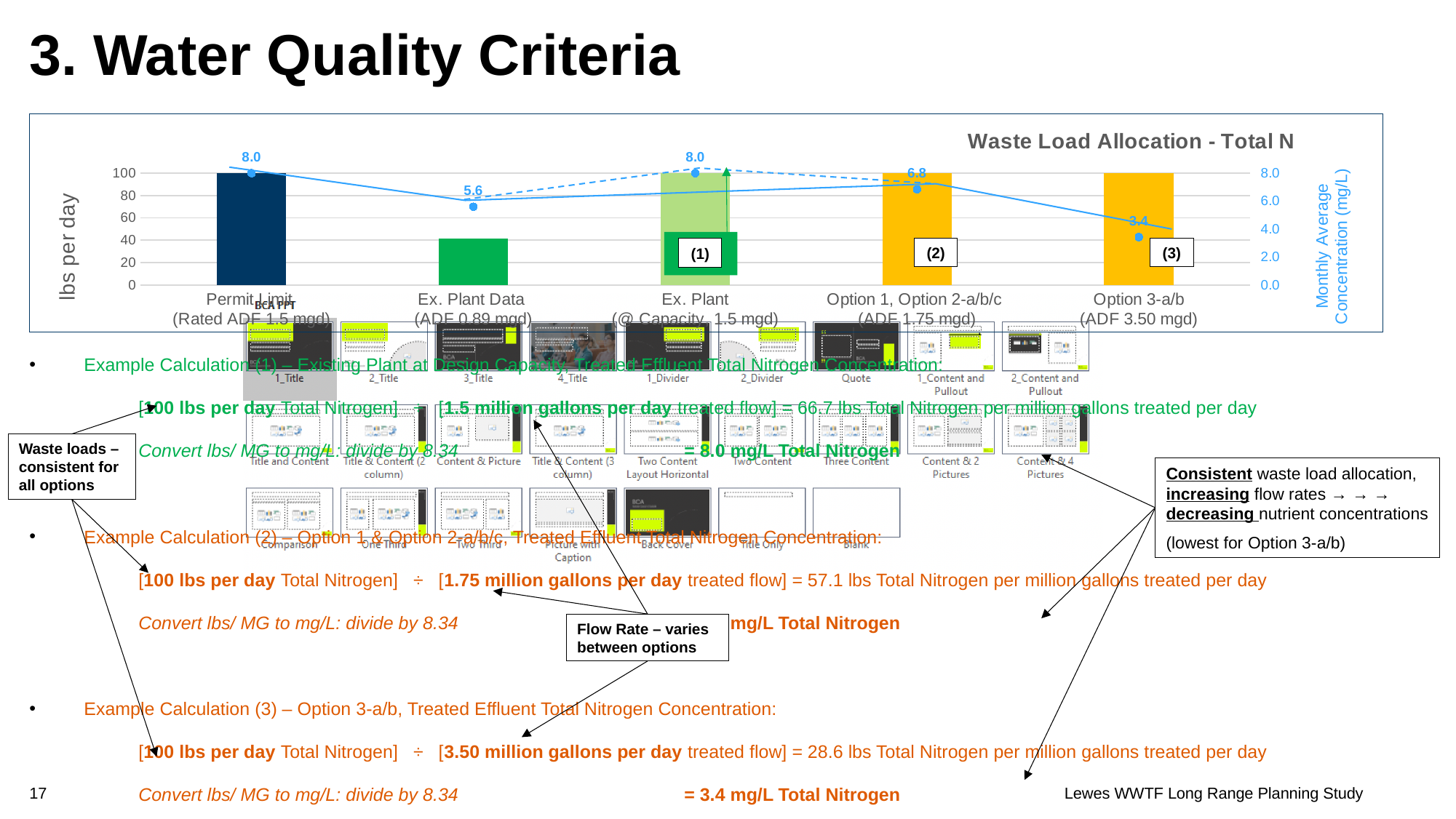
What is the Monthly Average Concentration (mg/L) value shown for Ex. Plant Data (ADF 0.89 mgd)? 5.6 What is the title of the chart? Waste Load Allocation - Total N What is the Monthly Average Concentration (mg/L) value shown for Option 1, Option 2-a/b/c (ADF 1.75 mgd)? 6.8 Is the lbs per day bar for Ex. Plant Data (ADF 0.89 mgd) greater or less than 60? less What is the Monthly Average Concentration (mg/L) value shown for Option 3-a/b (ADF 3.50 mgd)? 3.4 Which has a higher Monthly Average Concentration value: Ex. Plant Data or Option 1, Option 2-a/b/c? Option 1, Option 2-a/b/c What is the Monthly Average Concentration (mg/L) value shown for Permit Limit (Rated ADF 1.5 mgd)? 8.0 What is the label of the left vertical axis of the chart? lbs per day Which category has the lowest Monthly Average Concentration (mg/L) value? Option 3-a/b (ADF 3.50 mgd) How many categories are shown on the x axis of the chart? 5 What is the difference between the Monthly Average Concentration values for Option 1, Option 2-a/b/c (6.8) and Ex. Plant Data (5.6)? 1.2 What is the difference between the Monthly Average Concentration values for Permit Limit (8.0) and Option 3-a/b (3.4)? 4.6